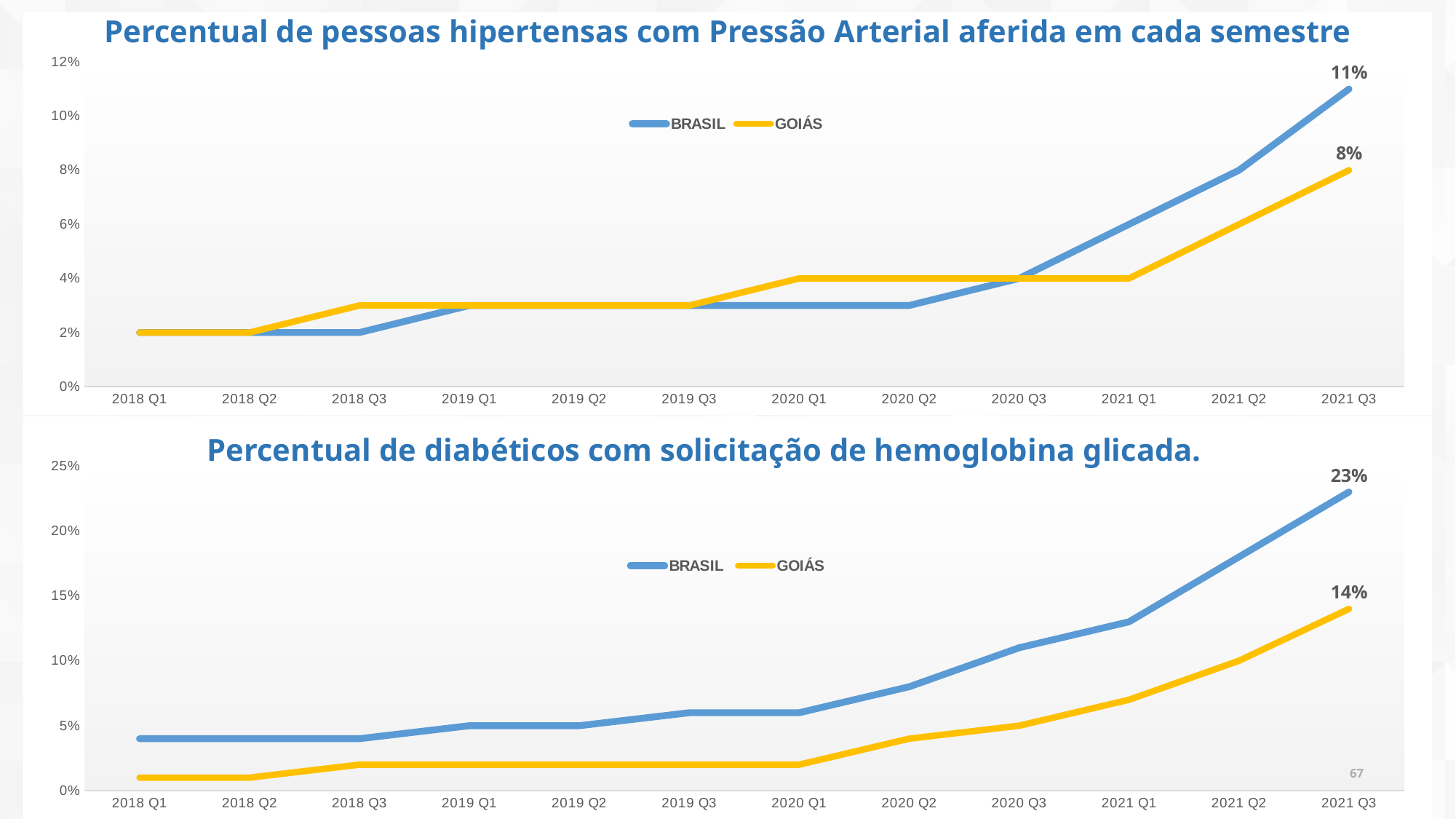
In the top chart (Percentual de pessoas hipertensas com Pressão Arterial aferida em cada semestre), what is the value for BRASIL in 2021 Q3? 11% In the bottom chart (Percentual de diabéticos com solicitação de hemoglobina glicada), what is the value for GOIÁS in 2021 Q3? 14% How many series does the legend of the top chart list? 2 In the bottom chart (Percentual de diabéticos com solicitação de hemoglobina glicada), what is the value for BRASIL in 2021 Q3? 23% In the top chart, what is the difference between the BRASIL and GOIÁS values in 2021 Q3? 3% In the top chart (Percentual de pessoas hipertensas com Pressão Arterial aferida em cada semestre), what is the value for GOIÁS in 2021 Q3? 8% In the bottom chart, is the value for GOIÁS in 2021 Q1 greater or less than 10%? less In the bottom chart, what is the difference between the BRASIL and GOIÁS values in 2021 Q3? 9% What type of chart is the bottom chart? line chart In the bottom chart, does the BRASIL series generally rise or fall from 2018 Q1 to 2021 Q3? rise In the top chart, which series has the higher value in 2021 Q3, BRASIL or GOIÁS? BRASIL